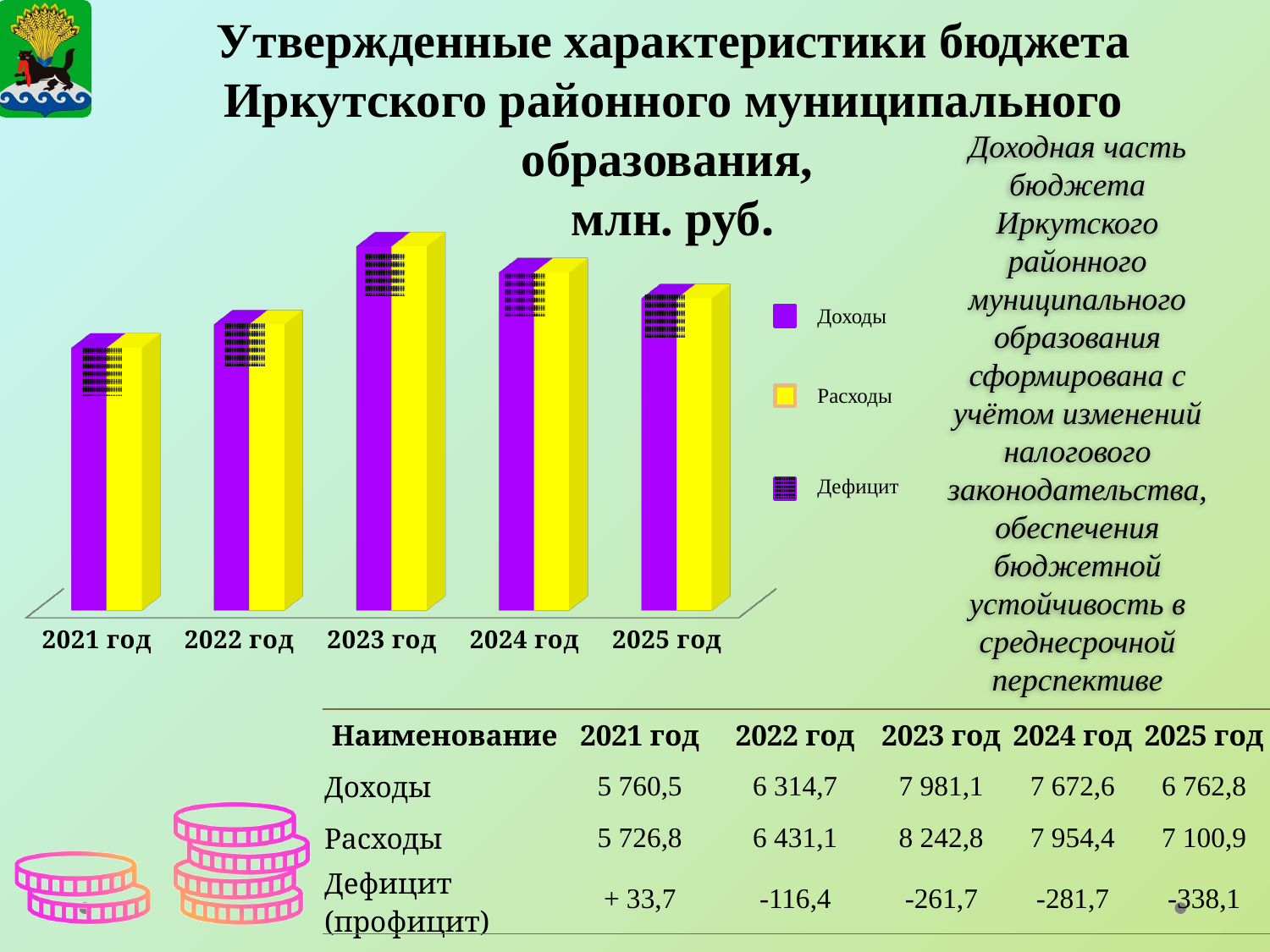
According to the table on the slide, what is the value of Расходы for 2025 год? 7 100,9 What kind of chart is shown on the slide? bar chart Do the Расходы bars rise or fall from 2023 год to 2025 год? fall Using the table values, what is the difference between Расходы and Доходы for 2023 год? 261,7 Which year has the highest Доходы bar in the chart? 2023 год Which year has the lowest Расходы bar in the chart? 2021 год According to the table on the slide, what is the value of Доходы for 2023 год? 7 981,1 According to the table on the slide, what is the Дефицит (профицит) value for 2021 год? + 33,7 Is the Доходы bar for 2023 год taller or shorter than the Доходы bar for 2021 год? taller How many years (categories) are shown on the x axis of the chart? 5 Which colour represents Расходы in the chart legend? yellow How many series does the chart legend list? 3